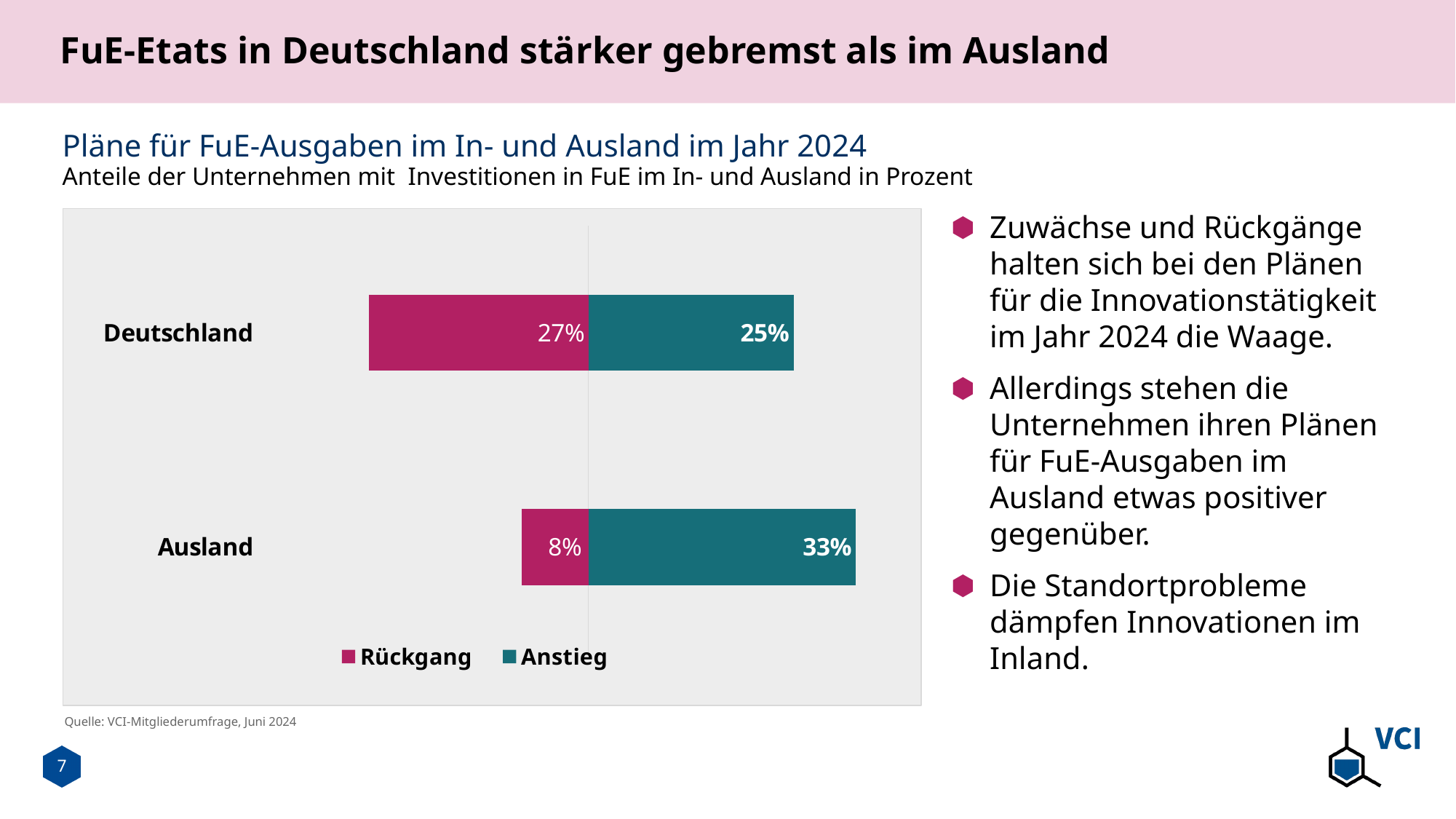
What is the Anstieg value for Deutschland? 25% How many series does the legend list? 2 What is the Anstieg value for Ausland? 33% What kind of chart is shown on the slide? bar chart Which category has the lower Anstieg value? Deutschland What is the Rückgang value for Deutschland? 27% What is the difference between the Anstieg values for Ausland and Deutschland? 8 percentage points What is the Rückgang value for Ausland? 8% How many categories are shown on the chart? 2 What is the difference between the Rückgang values for Deutschland and Ausland? 19 percentage points Which category has the higher Rückgang value? Deutschland Is the Anstieg value for Ausland larger or smaller than the Anstieg value for Deutschland? larger